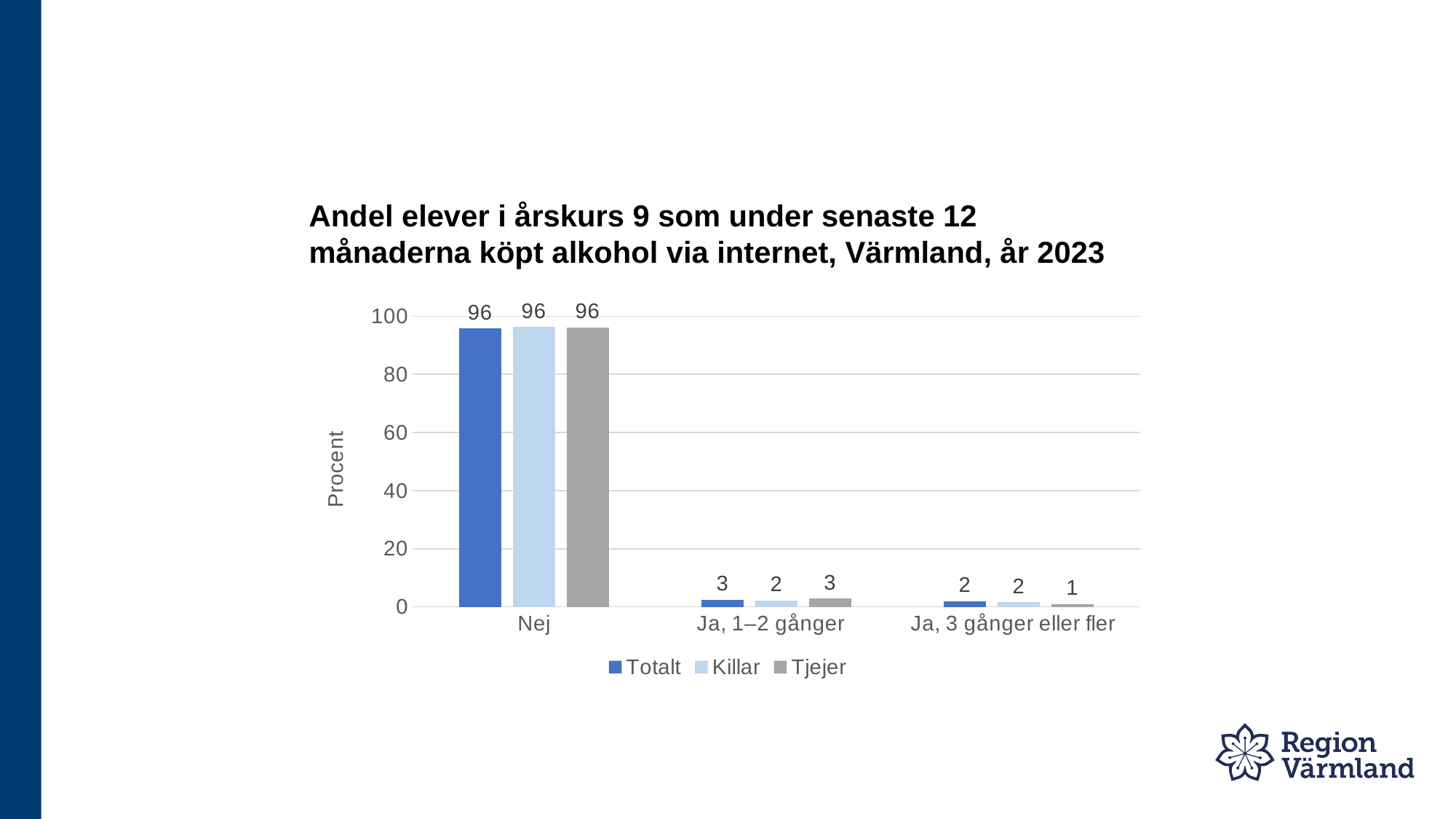
In the 'Ja, 1–2 gånger' category, which is larger: Killar or Tjejer? Tjejer Which category has the lowest value for Tjejer? Ja, 3 gånger eller fler What kind of chart is shown on the slide? Bar chart What is the value for Tjejer in the 'Ja, 1–2 gånger' category? 3 Which category has the highest value for Totalt? Nej How many series does the legend list? 3 What is the value for Tjejer in the 'Ja, 3 gånger eller fler' category? 1 What is the difference between the Totalt value for Nej and the Totalt value for 'Ja, 1–2 gånger'? 93 How many categories are shown on the x axis? 3 What is the value for Totalt in the Nej category? 96 What is the value for Killar in the 'Ja, 1–2 gånger' category? 2 Is the value for Killar in the Nej category greater or less than 80? greater